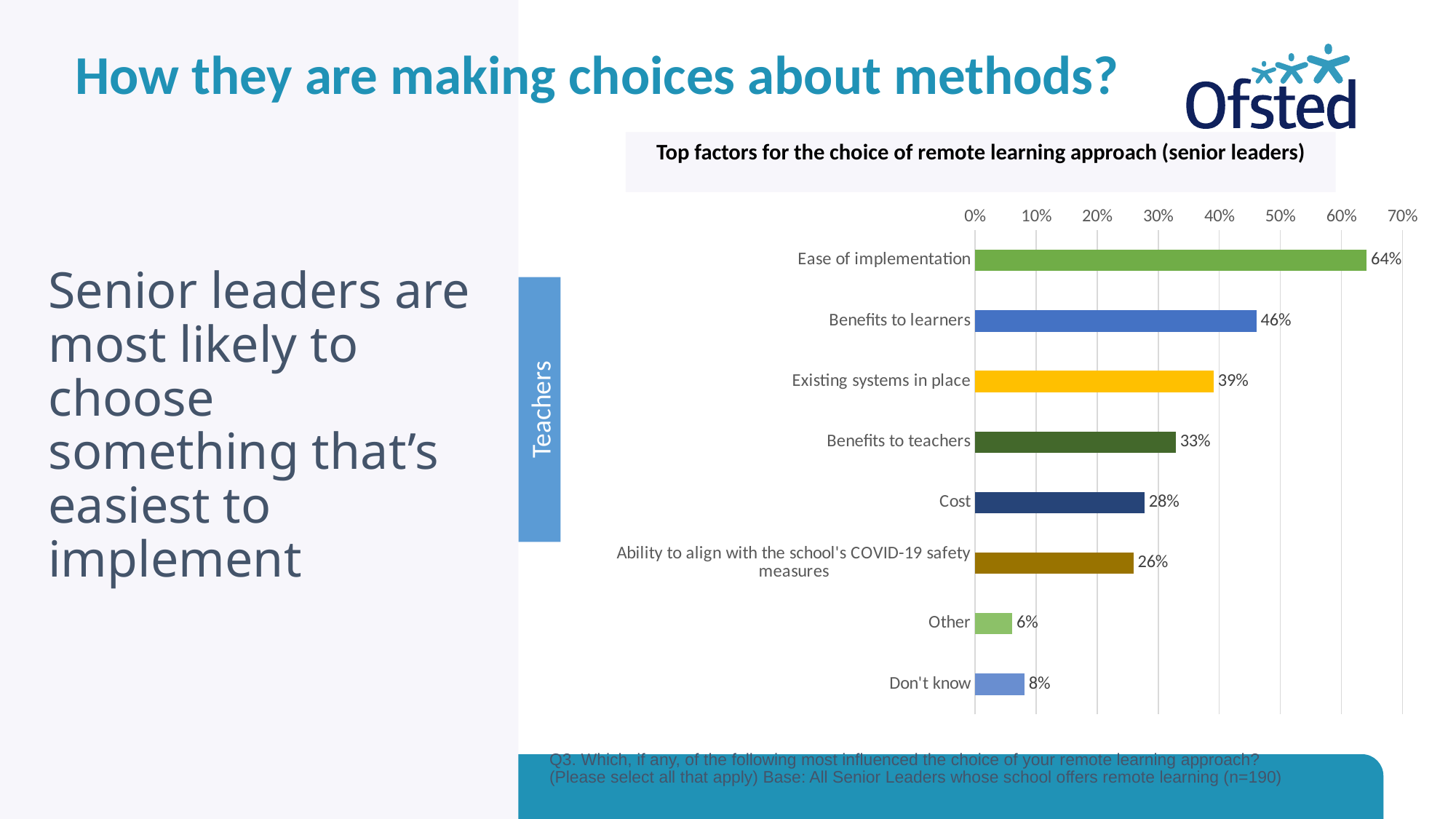
Which is larger: 'Existing systems in place' or 'Benefits to teachers'? Existing systems in place What is the title of the chart? Top factors for the choice of remote learning approach (senior leaders) Is the value for 'Benefits to teachers' greater or less than 30%? greater What kind of chart is shown on the slide? Bar chart What percentage of senior leaders chose 'Ease of implementation' as a top factor? 64% What is the value for 'Ability to align with the school's COVID-19 safety measures'? 26% Which factor has the highest value? Ease of implementation What is the value for 'Cost'? 28% What is the value for 'Benefits to learners'? 46% What is the difference between 'Ease of implementation' and 'Benefits to learners'? 18% Which category has the lowest value? Other How many categories are shown in the chart? 8